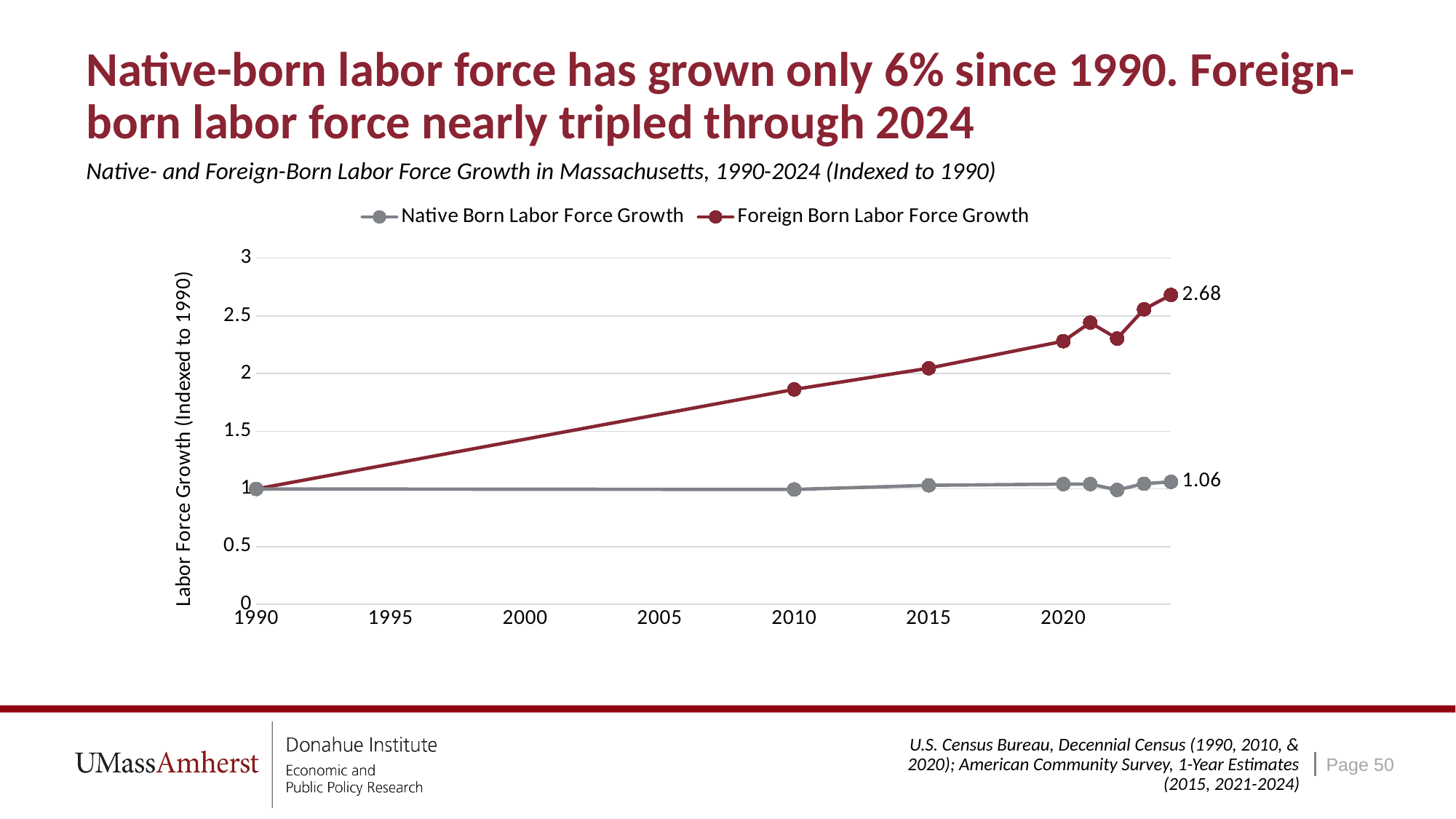
In 2024, which series has the larger value, Native Born Labor Force Growth or Foreign Born Labor Force Growth? Foreign Born Labor Force Growth What is the value of Native Born Labor Force Growth in 2024? 1.06 Is the value for Foreign Born Labor Force Growth in 2020 greater or less than 2? greater What is the value of Foreign Born Labor Force Growth in 2024? 2.68 How many series does the legend list? 2 Is the value for Native Born Labor Force Growth in 2010 greater or less than 1.5? less Is the value for Foreign Born Labor Force Growth in 2010 greater or less than 1.5? greater In which year does Foreign Born Labor Force Growth reach its highest value? 2024 What is the difference between the Foreign Born and Native Born Labor Force Growth values in 2024? 1.62 Does the Foreign Born Labor Force Growth line generally rise or fall from 1990 to 2024? Rise What kind of chart is shown on the slide? Line chart What is the label on the vertical axis of the chart? Labor Force Growth (Indexed to 1990)